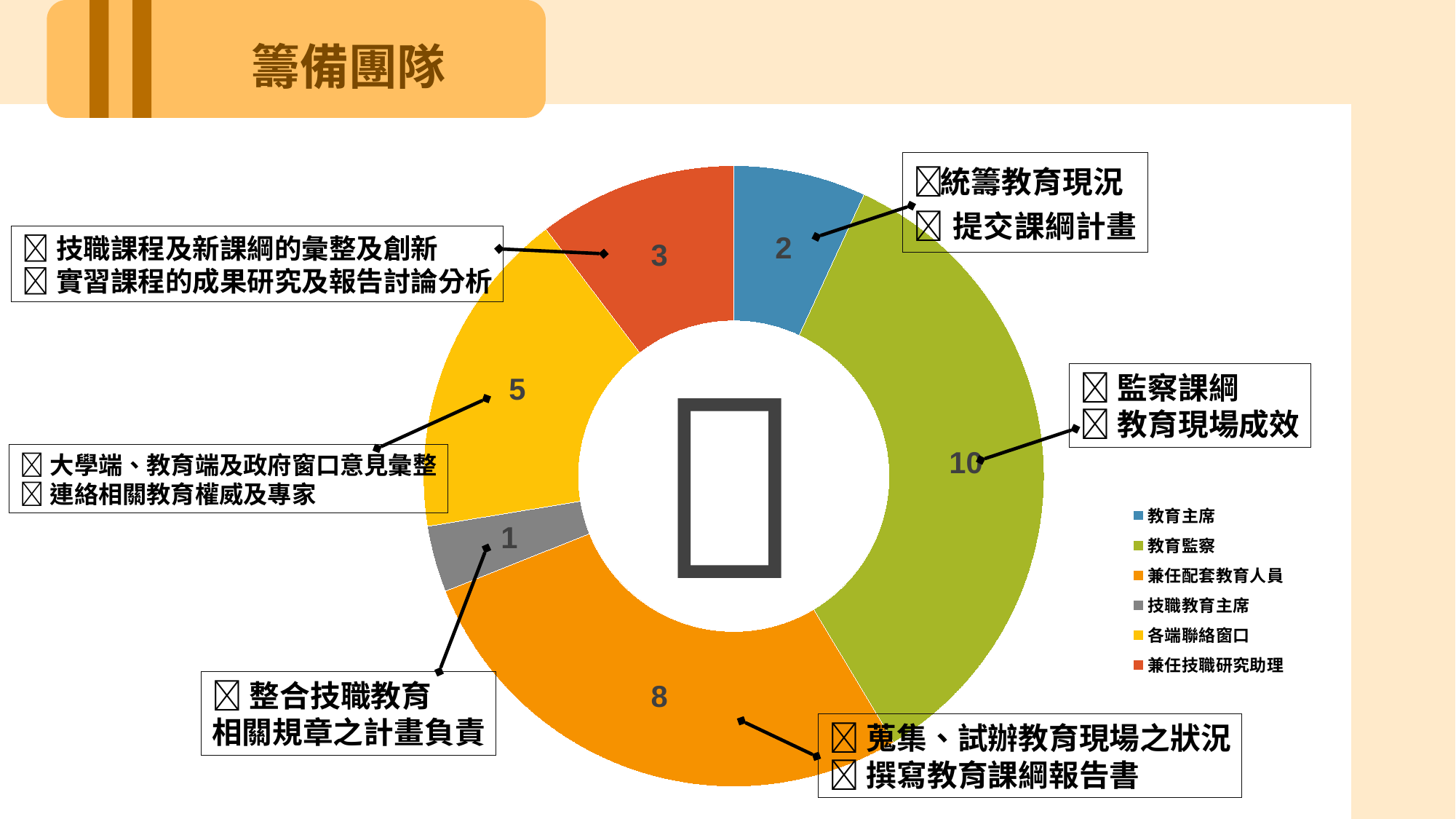
Which category has the smallest value? 技職教育主席 How many categories does the legend list? 6 Which is larger, the value for 各端聯絡窗口 or the value for 兼任技職研究助理? 各端聯絡窗口 What is the value for 各端聯絡窗口? 5 What is the value for 教育監察? 10 What is the total of all the values shown on the chart? 29 What colour is the segment for 技職教育主席? Gray What is the value for 教育主席? 2 What kind of chart is shown on the slide? Doughnut (pie) chart What is the difference between the values for 教育監察 and 兼任配套教育人員? 2 Which category has the largest value? 教育監察 What is the value for 兼任配套教育人員? 8